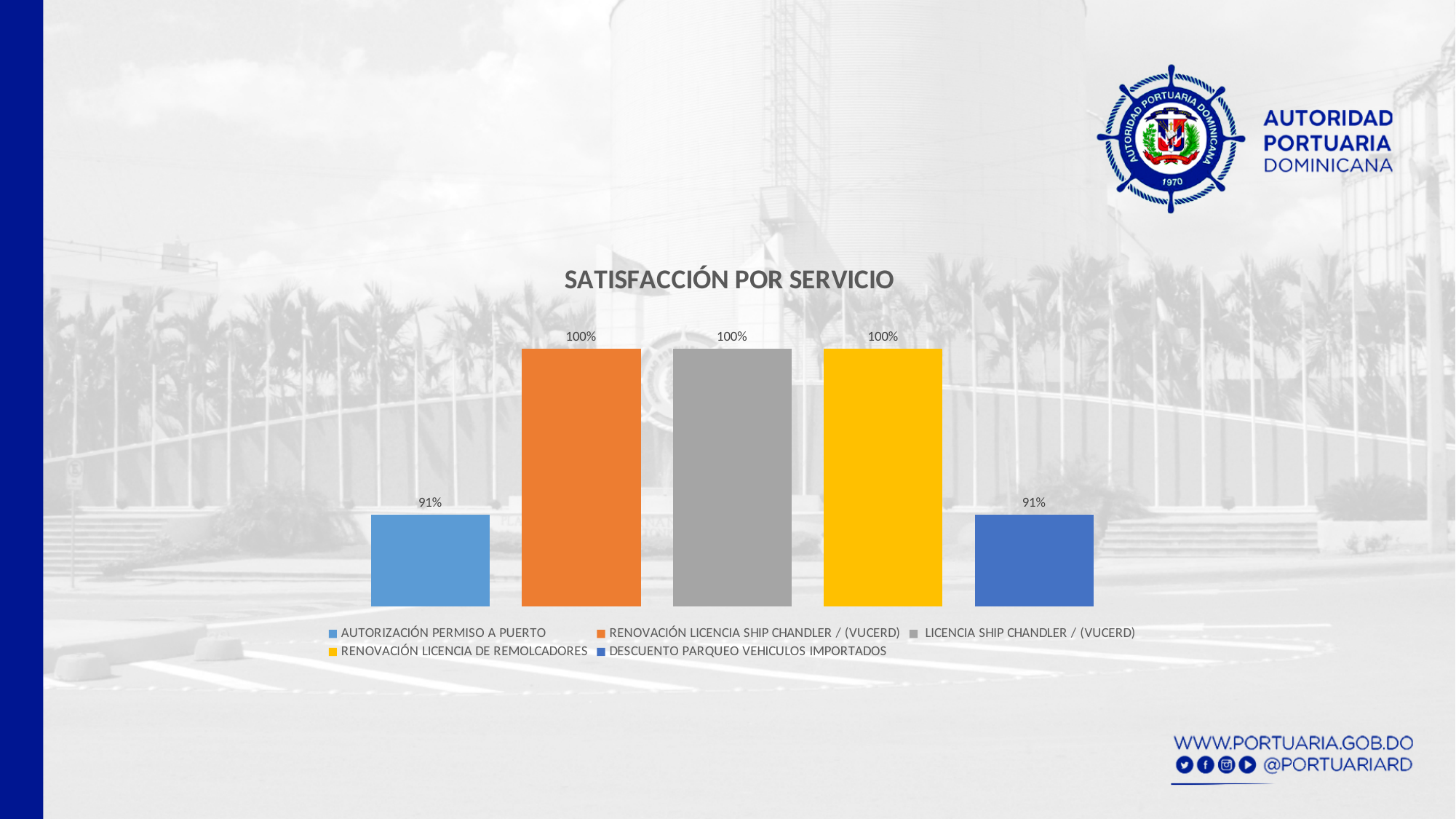
How many entries does the legend list? 5 What is the satisfaction value for RENOVACIÓN LICENCIA SHIP CHANDLER / (VUCERD)? 100% Which is larger, the value for AUTORIZACIÓN PERMISO A PUERTO or the value for RENOVACIÓN LICENCIA DE REMOLCADORES? RENOVACIÓN LICENCIA DE REMOLCADORES What colour is the bar for RENOVACIÓN LICENCIA DE REMOLCADORES? Yellow What is the satisfaction value for AUTORIZACIÓN PERMISO A PUERTO? 91% What is the satisfaction value for LICENCIA SHIP CHANDLER / (VUCERD)? 100% What is the title of the chart? SATISFACCIÓN POR SERVICIO What kind of chart is shown on the slide? Bar chart What is the satisfaction value for RENOVACIÓN LICENCIA DE REMOLCADORES? 100% What is the difference between the value for LICENCIA SHIP CHANDLER / (VUCERD) and the value for DESCUENTO PARQUEO VEHICULOS IMPORTADOS? 9% How many bars are plotted in the chart? 5 What is the satisfaction value for DESCUENTO PARQUEO VEHICULOS IMPORTADOS? 91%